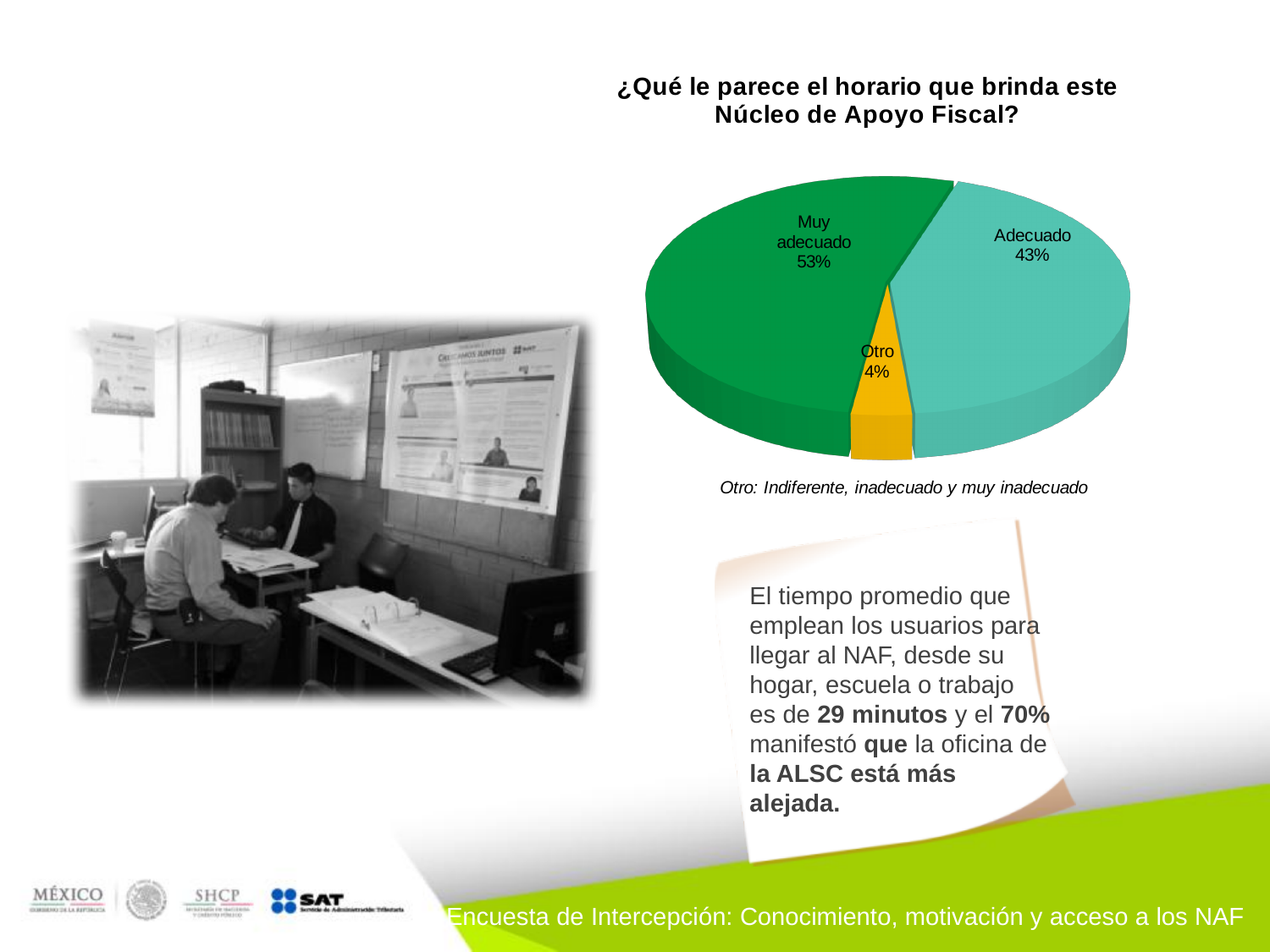
Which slice of the pie chart is the smallest? Otro What share of the pie chart is labelled "Adecuado"? 43% What question is the pie chart answering, according to its title? ¿Qué le parece el horario que brinda este Núcleo de Apoyo Fiscal? What is the difference in percentage points between the "Muy adecuado" and "Adecuado" slices? 10 Which slice of the pie chart is the largest? Muy adecuado What share of the pie chart is labelled "Muy adecuado"? 53% According to the note under the pie chart, what does the "Otro" category include? Indiferente, inadecuado y muy inadecuado What kind of chart is shown on the slide? Pie chart How many slices does the pie chart have? 3 What is the combined share of the "Muy adecuado" and "Adecuado" slices? 96% Which is larger in the pie chart, "Adecuado" or "Otro"? Adecuado What share of the pie chart is labelled "Otro"? 4%